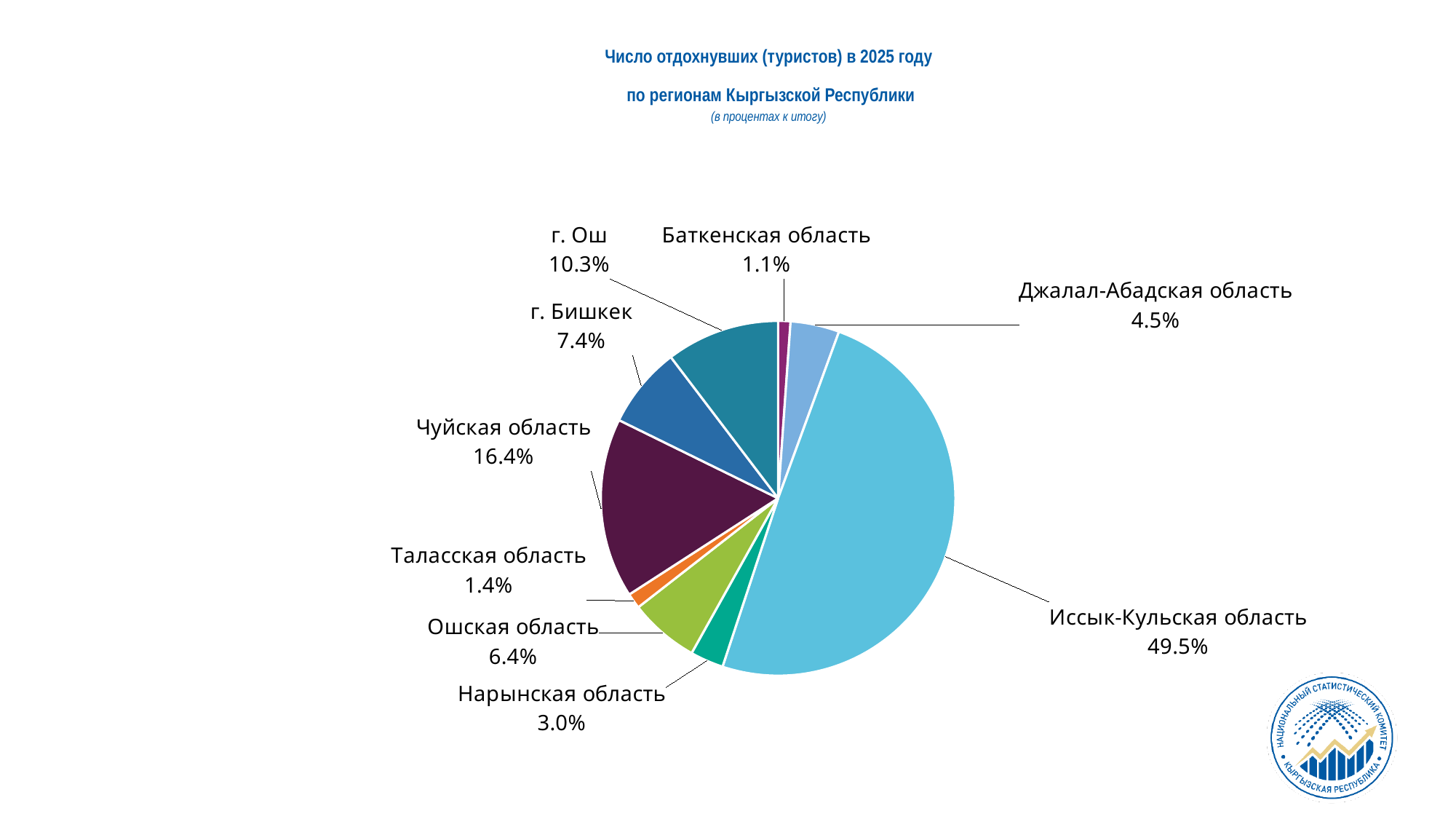
Which region has the largest slice of the pie? Иссык-Кульская область What is the value shown for г. Ош? 10.3% What is the value shown for Нарынская область? 3.0% How many slices does the pie chart have? 9 Which region has the smallest slice of the pie? Баткенская область What share of the pie does Иссык-Кульская область hold? 49.5% What is the value shown for Чуйская область? 16.4% Which is larger, the share of Ошская область or the share of Джалал-Абадская область? Ошская область What kind of chart is shown on the slide? Pie chart What is the difference between the shares of Чуйская область and г. Бишкек? 9.0% What is the combined share of г. Ош and г. Бишкек? 17.7% What year does the chart title refer to? 2025